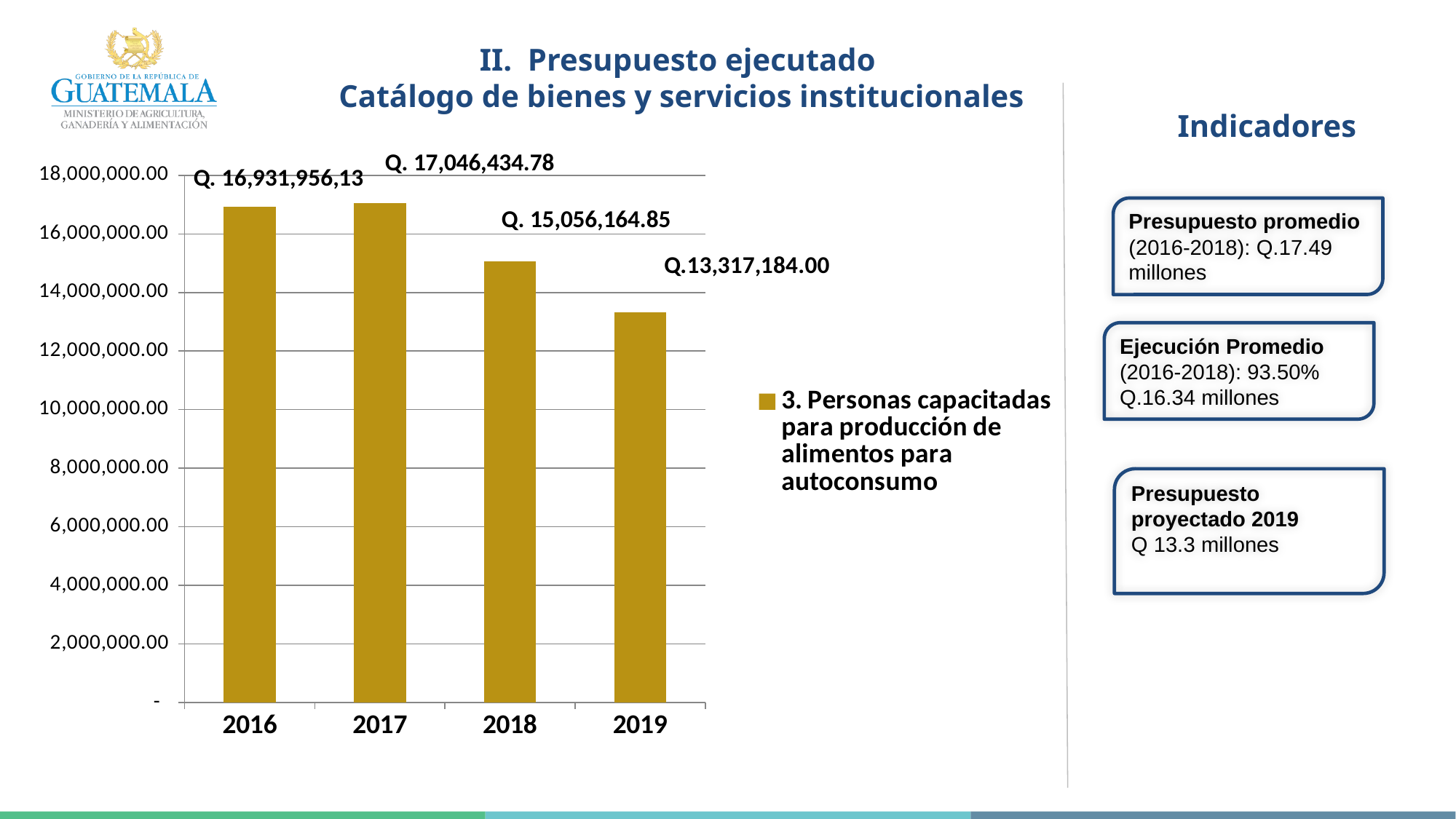
Which year has the highest value? 2017 Do the values rise or fall from 2017 to 2019? fall Is the value for 2019 greater or less than 14,000,000.00? less What kind of chart is shown? bar chart Which year has the lowest value? 2019 How many years are shown on the x axis? 4 What is the value for 2018? Q. 15,056,164.85 What is the difference between the values for 2017 and 2018? Q. 1,990,269.93 What is the value for 2017? Q. 17,046,434.78 What is the value for 2016? Q. 16,931,956,13 What is the value for 2019? Q.13,317,184.00 Which is larger, the value for 2018 or the value for 2019? 2018